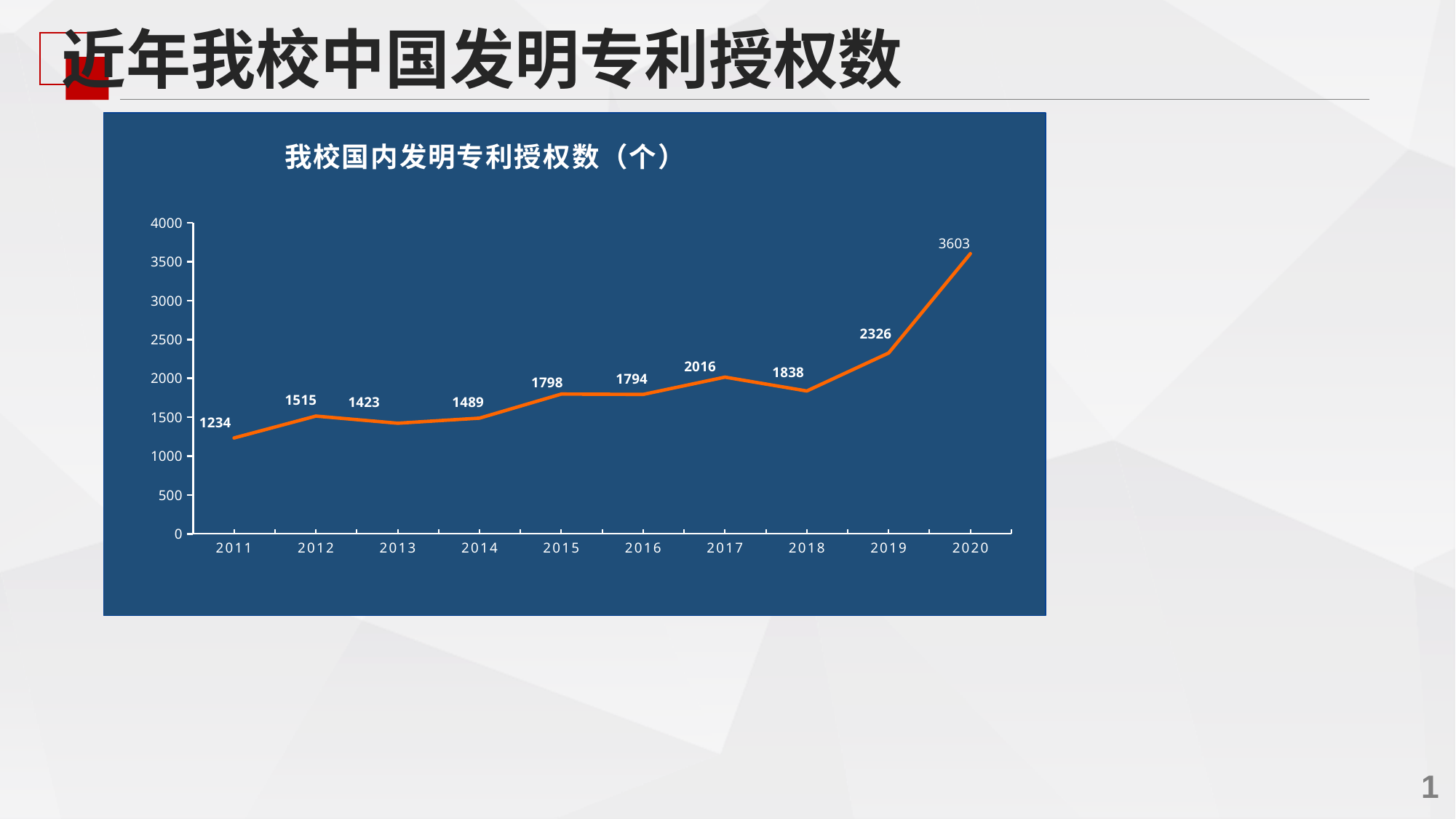
What is the title of the chart? 我校国内发明专利授权数（个） What is the value for 2020? 3603 What is the difference between the values for 2020 and 2019? 1277 How many years are plotted on the chart? 10 What kind of chart is shown on the slide? line chart Which year has the lowest value? 2011 Which year has the highest value? 2020 Which is larger, the value for 2017 or the value for 2018? 2017 Is the value for 2019 greater or less than 2000? greater What is the value for 2017? 2016 What is the difference between the values for 2012 and 2013? 92 What is the value for 2011? 1234